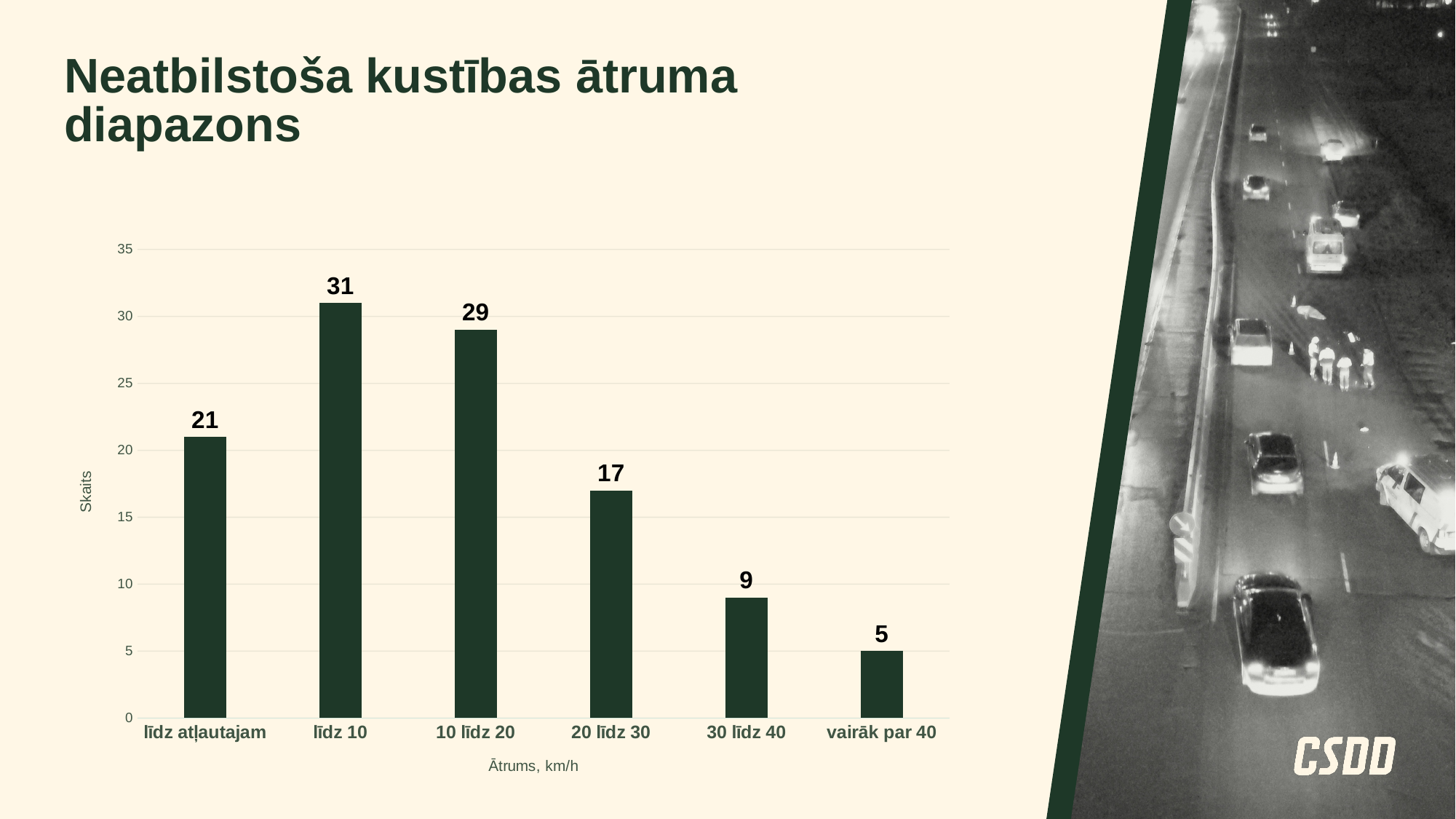
What is the label of the x axis? Ātrums, km/h What is the difference between the values for "līdz 10" and "10 līdz 20"? 2 What is the value for the category "līdz 10"? 31 Which is larger, the value for "līdz atļautajam" or the value for "20 līdz 30"? līdz atļautajam What kind of chart is shown on the slide? bar chart What is the difference between the values for "līdz atļautajam" and "30 līdz 40"? 12 What is the value for the category "20 līdz 30"? 17 How many categories are shown on the x axis? 6 Is the value for "10 līdz 20" greater or less than 25? greater Which category has the lowest value? vairāk par 40 Which category has the highest value? līdz 10 What is the value for the category "vairāk par 40"? 5